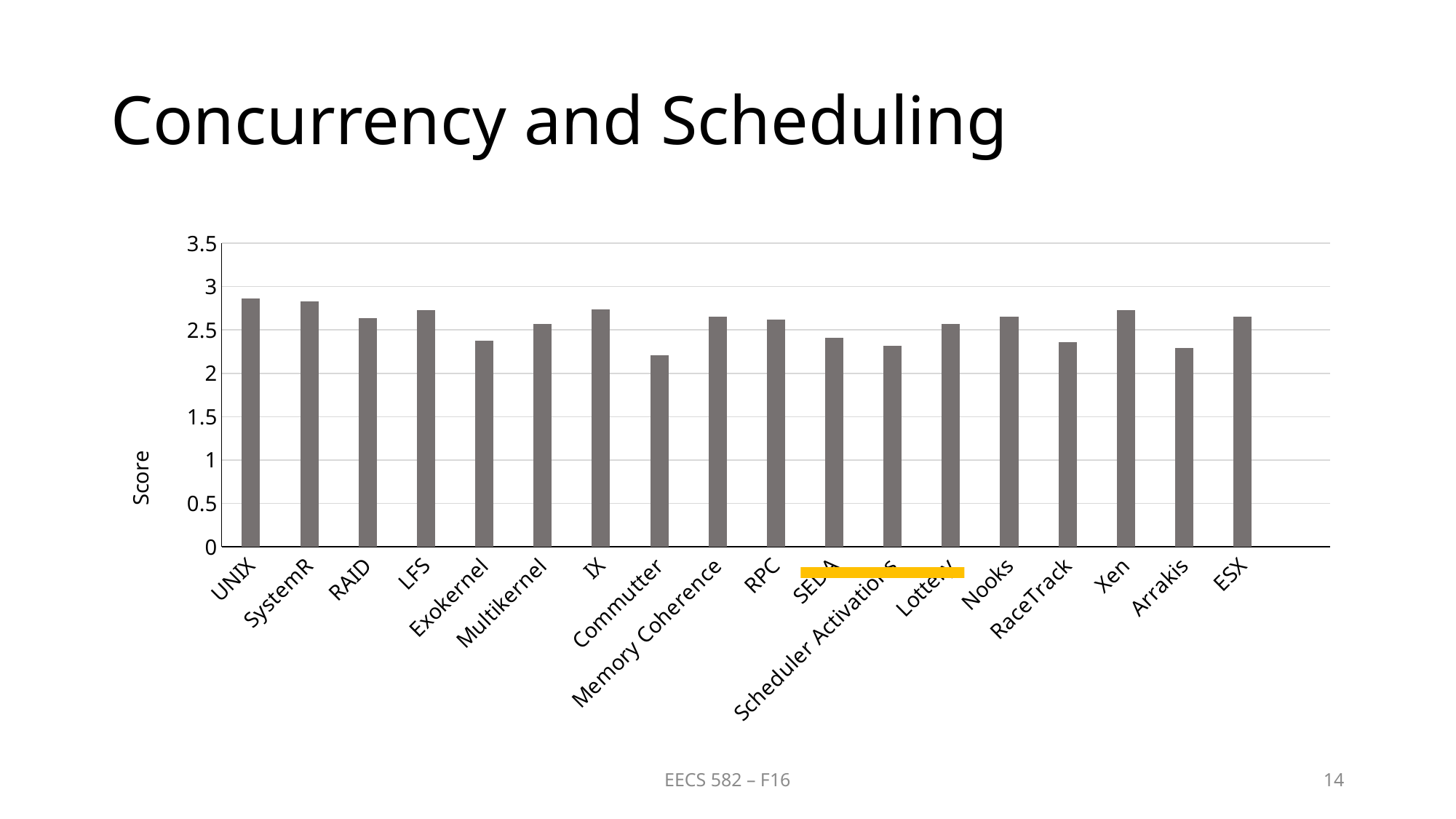
Is the value for Commutter greater or less than 2.5? less What kind of chart is shown on the slide? bar chart What is the label on the vertical axis of the chart? Score Which has the larger score, LFS or Exokernel? LFS Which category has the lowest score in the chart? Commutter How many categories (bars) are plotted in the chart? 18 Is the value for UNIX greater or less than 2.5? greater Is the value for Exokernel greater or less than 2.5? less Which has the larger score, UNIX or Commutter? UNIX Which has the larger score, Xen or Arrakis? Xen